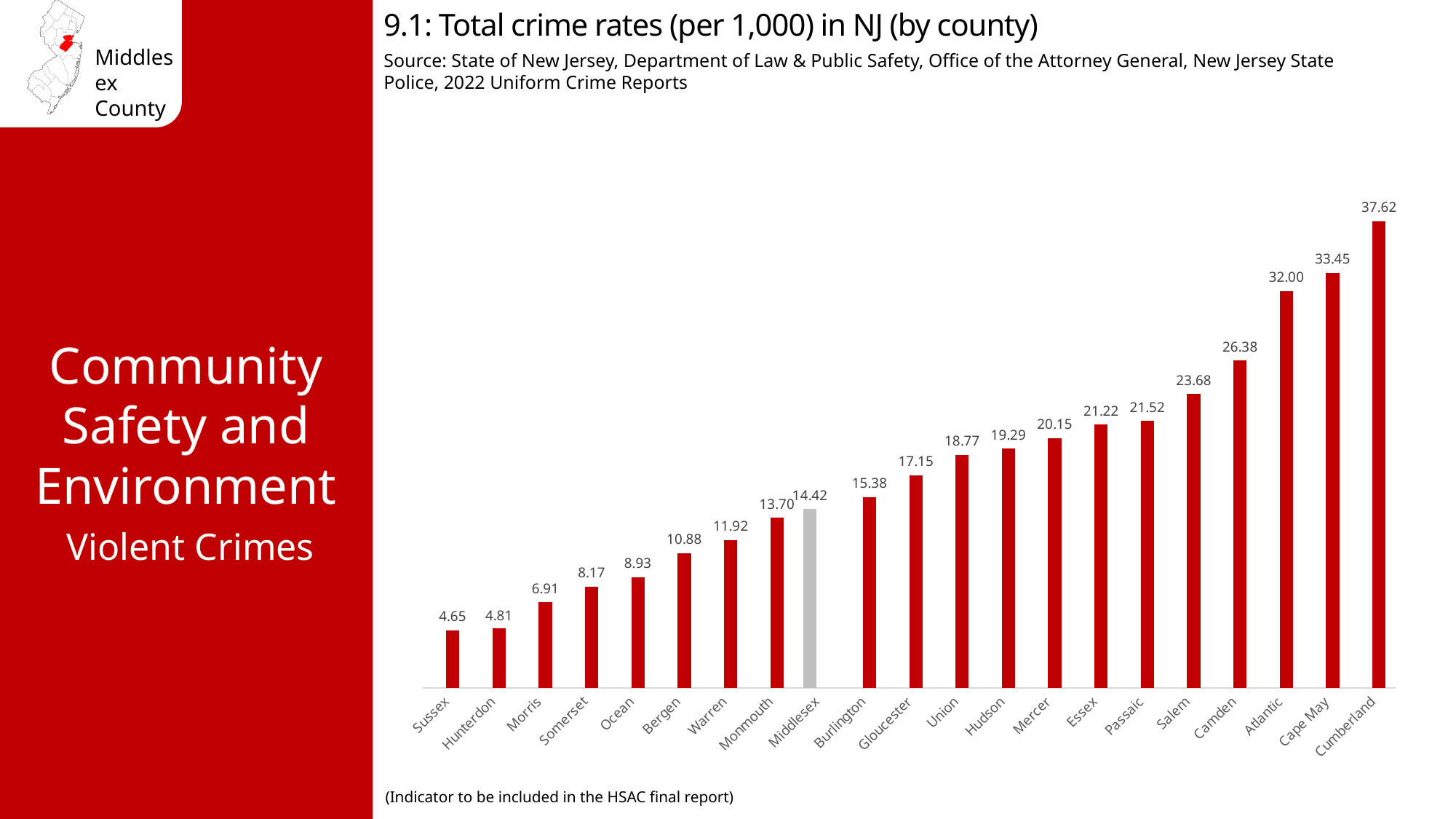
What is the difference between the total crime rates of Cape May and Atlantic? 1.45 How many counties are shown in the chart? 21 What is the total crime rate (per 1,000) for Middlesex County? 14.42 What is the total crime rate (per 1,000) for Cape May County? 33.45 Do the total crime rates rise or fall moving from left to right across the counties? Rise Which county's bar is shown in grey instead of red? Middlesex Which county has the lowest total crime rate? Sussex What is the difference between the total crime rates of Cumberland and Sussex? 32.97 What is the total crime rate (per 1,000) for Hudson County? 19.29 What kind of chart is used to show total crime rates by county? Bar chart Which county has a higher total crime rate, Camden or Salem? Camden Which county has the highest total crime rate? Cumberland